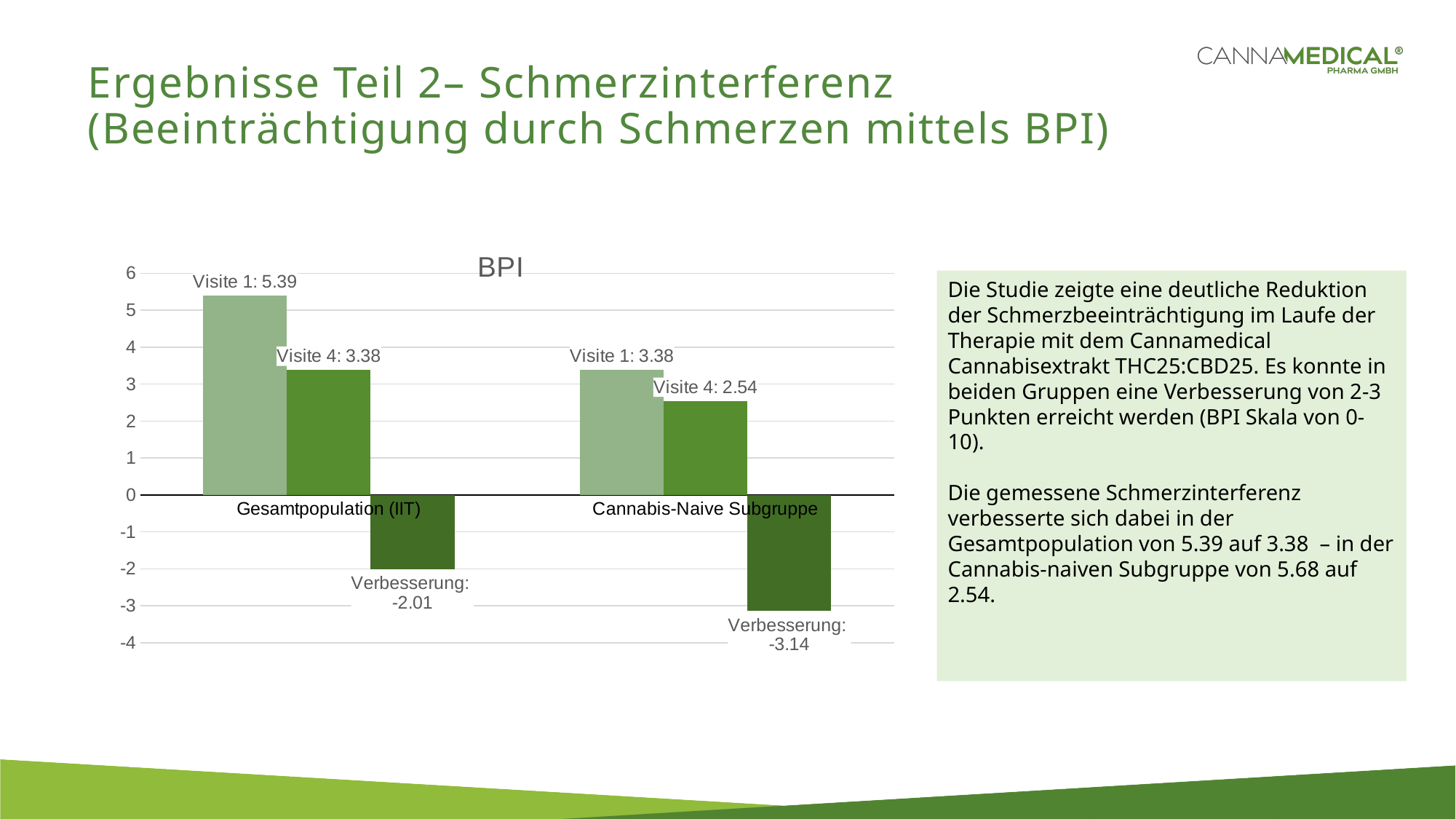
What is the Verbesserung value for the Cannabis-Naive Subgruppe in the BPI chart? -3.14 What kind of chart is shown on the slide? Bar chart What is the Visite 4 value for the Cannabis-Naive Subgruppe in the BPI chart? 2.54 Which bar in the BPI chart has the lowest value? Verbesserung for Cannabis-Naive Subgruppe What is the Visite 1 value for the Cannabis-Naive Subgruppe in the BPI chart? 3.38 Which bar in the BPI chart has the highest value? Visite 1 for Gesamtpopulation (IIT) What is the Visite 1 value for Gesamtpopulation (IIT) in the BPI chart? 5.39 What is the Verbesserung value for Gesamtpopulation (IIT) in the BPI chart? -2.01 Which group has the larger Visite 4 value: Gesamtpopulation (IIT) or Cannabis-Naive Subgruppe? Gesamtpopulation (IIT) What is the difference between the Visite 4 values of Gesamtpopulation (IIT) and the Cannabis-Naive Subgruppe? 0.84 What is the Visite 4 value for Gesamtpopulation (IIT) in the BPI chart? 3.38 How many groups (categories) are shown on the x axis of the BPI chart? 2